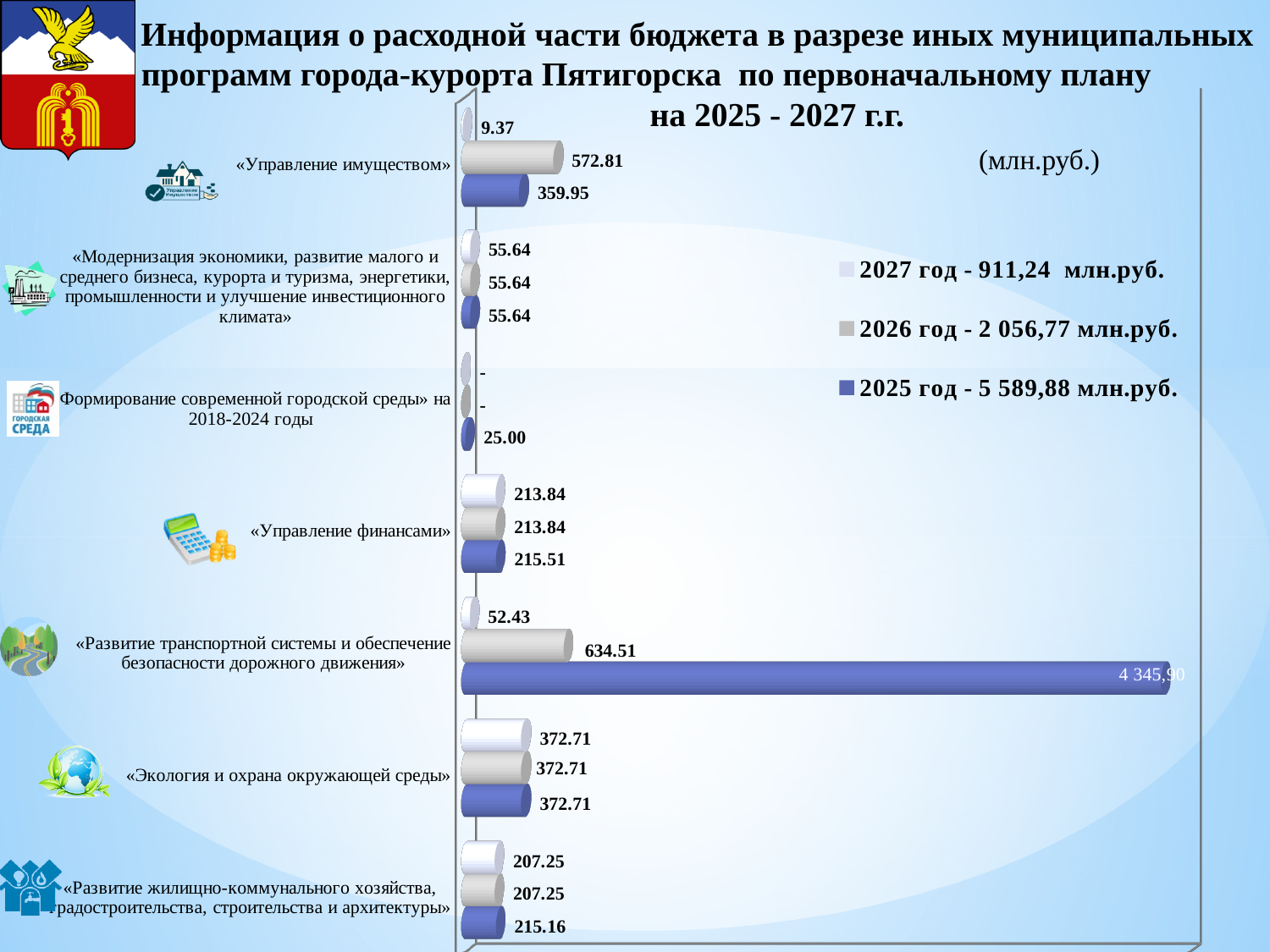
What is the 2027 value for «Управление финансами»? 213.84 What total for 2025 год is shown in the legend? 5 589,88 млн.руб. How many series does the legend list? 3 How many program categories are plotted in the chart? 7 What type of chart is shown on the slide? bar chart What is the 2025 value for «Формирование современной городской среды» на 2018-2024 годы? 25.00 Which program has the lowest 2027 value? «Формирование современной городской среды» на 2018-2024 годы Which program has the highest 2025 value? «Развитие транспортной системы и обеспечение безопасности дорожного движения» What is the 2026 value for «Управление имуществом»? 572.81 What is the difference between the 2026 and 2025 values for «Управление имуществом»? 212.86 Which is larger for «Развитие транспортной системы и обеспечение безопасности дорожного движения»: the 2026 value or the 2027 value? 2026 What is the 2025 value for «Развитие транспортной системы и обеспечение безопасности дорожного движения»? 4 345,90